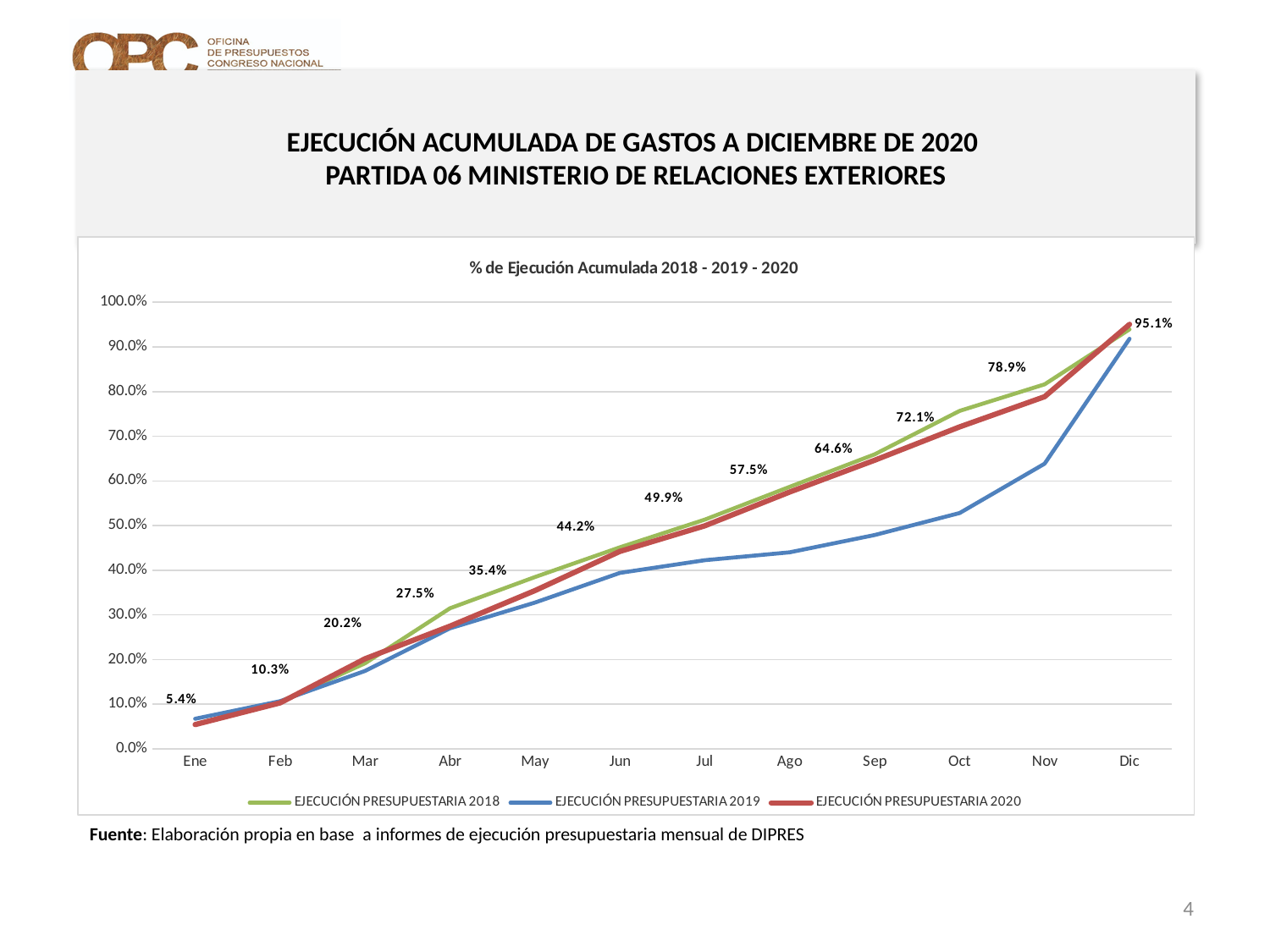
In which month is the EJECUCIÓN PRESUPUESTARIA 2020 value lowest? Ene Which series is higher in Nov, EJECUCIÓN PRESUPUESTARIA 2018 or EJECUCIÓN PRESUPUESTARIA 2019? EJECUCIÓN PRESUPUESTARIA 2018 What is the value for EJECUCIÓN PRESUPUESTARIA 2020 in Oct? 72.1% How many series does the legend list? 3 Is the value for EJECUCIÓN PRESUPUESTARIA 2019 in Nov greater or less than 70.0%? less What kind of chart is shown on the slide? line chart What is the difference between the EJECUCIÓN PRESUPUESTARIA 2020 values for Nov and Oct? 6.8% How many months are shown on the x axis? 12 What is the value for EJECUCIÓN PRESUPUESTARIA 2020 in Jun? 44.2% Do the EJECUCIÓN PRESUPUESTARIA 2020 values rise or fall from Ene to Dic? rise What is the value for EJECUCIÓN PRESUPUESTARIA 2020 in Dic? 95.1% What is the value for EJECUCIÓN PRESUPUESTARIA 2020 in Ene? 5.4%